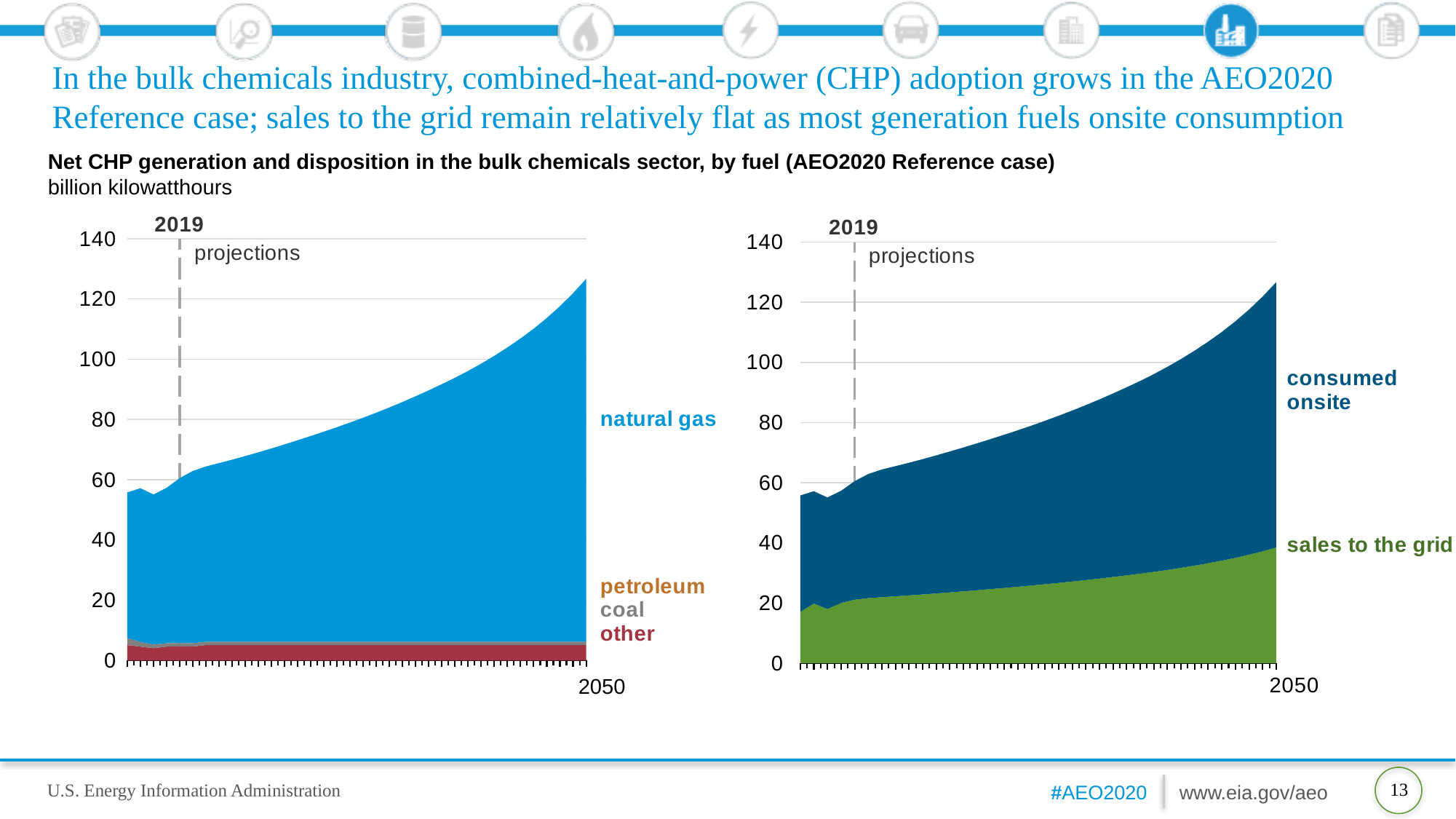
How many fuel series are labelled on the left chart? 4 What year marks the start of the projections on both charts? 2019 On the right chart, is the value for sales to the grid in 2050 greater or less than 20 billion kilowatthours? greater On the left chart, which fuel accounts for the largest share of net CHP generation? natural gas On the right chart, which is larger in 2050: generation consumed onsite or sales to the grid? consumed onsite On the left chart, does total net CHP generation rise or fall over the projection period to 2050? rise On the right chart, is total net CHP generation in 2050 greater or less than 100 billion kilowatthours? greater On the left chart, is total net CHP generation in 2050 greater or less than 120 billion kilowatthours? greater What is the last year shown on the x axis of the charts? 2050 What unit is used on the y axis of both charts? billion kilowatthours How many series are labelled on the right chart? 2 What kind of chart is the left chart on the slide? stacked area chart